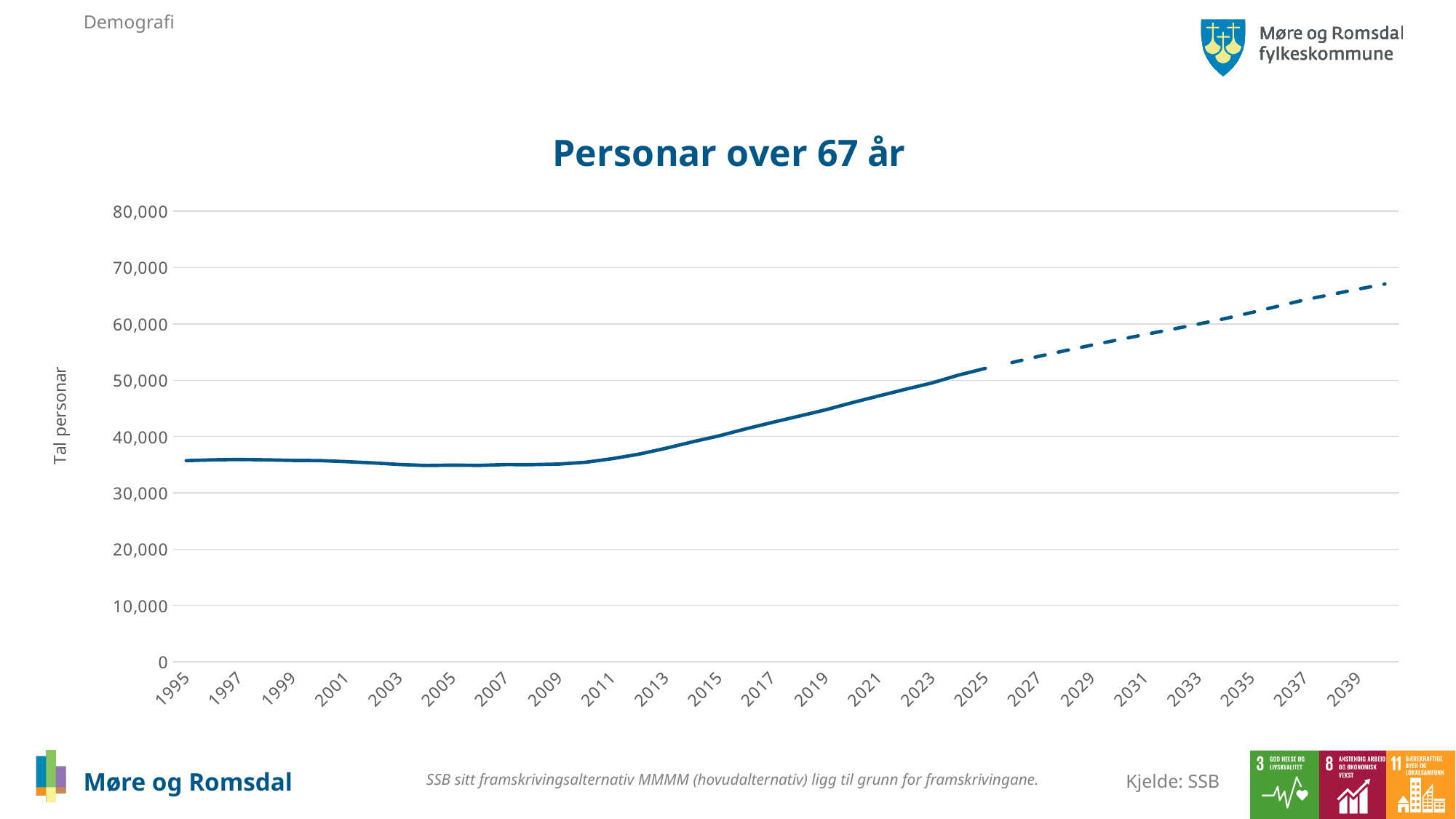
What is the label on the vertical axis of the chart? Tal personar Is the value for 2019 greater or less than 40,000? greater Do the values generally rise or fall along the x axis from 2011 to 2039? rise Is the value for 2039 greater or less than 60,000? greater What is the highest value shown on the vertical axis? 80,000 Is the value for 2005 greater or less than 40,000? less Which year has the larger value, 1995 or 2039? 2039 How many lines (series) are plotted on the chart? 2 What kind of chart is shown on the slide? line chart What is the title of the chart? Personar over 67 år